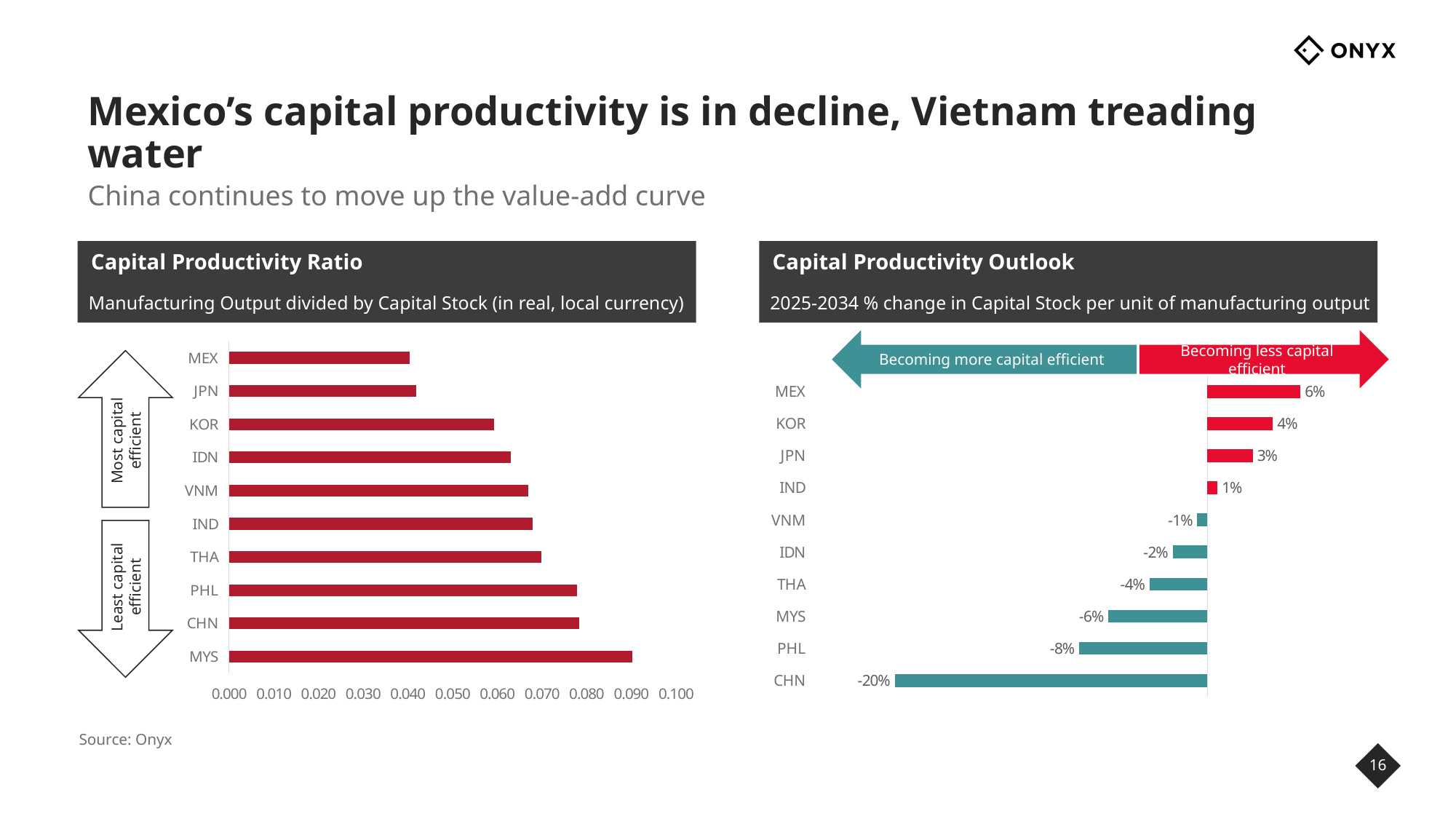
In the Capital Productivity Ratio chart, is the value for MEX greater or less than 0.050? less In the Capital Productivity Outlook chart, what is the value for CHN? -20% In the Capital Productivity Outlook chart, how many countries are shown? 10 In the Capital Productivity Ratio chart, is the value for MYS greater or less than 0.080? greater In the Capital Productivity Outlook chart, what is the value for MEX? 6% In the Capital Productivity Outlook chart, which country has the highest value? MEX In the Capital Productivity Outlook chart, what is the value for THA? -4% What kind of chart is the Capital Productivity Ratio chart? Bar chart In the Capital Productivity Ratio chart, which country has the highest value? MYS In the Capital Productivity Outlook chart, what is the difference between the values for MEX and KOR? 2 percentage points In the Capital Productivity Outlook chart, which country has the lowest value? CHN In the Capital Productivity Ratio chart, which is larger, the value for PHL or the value for KOR? PHL